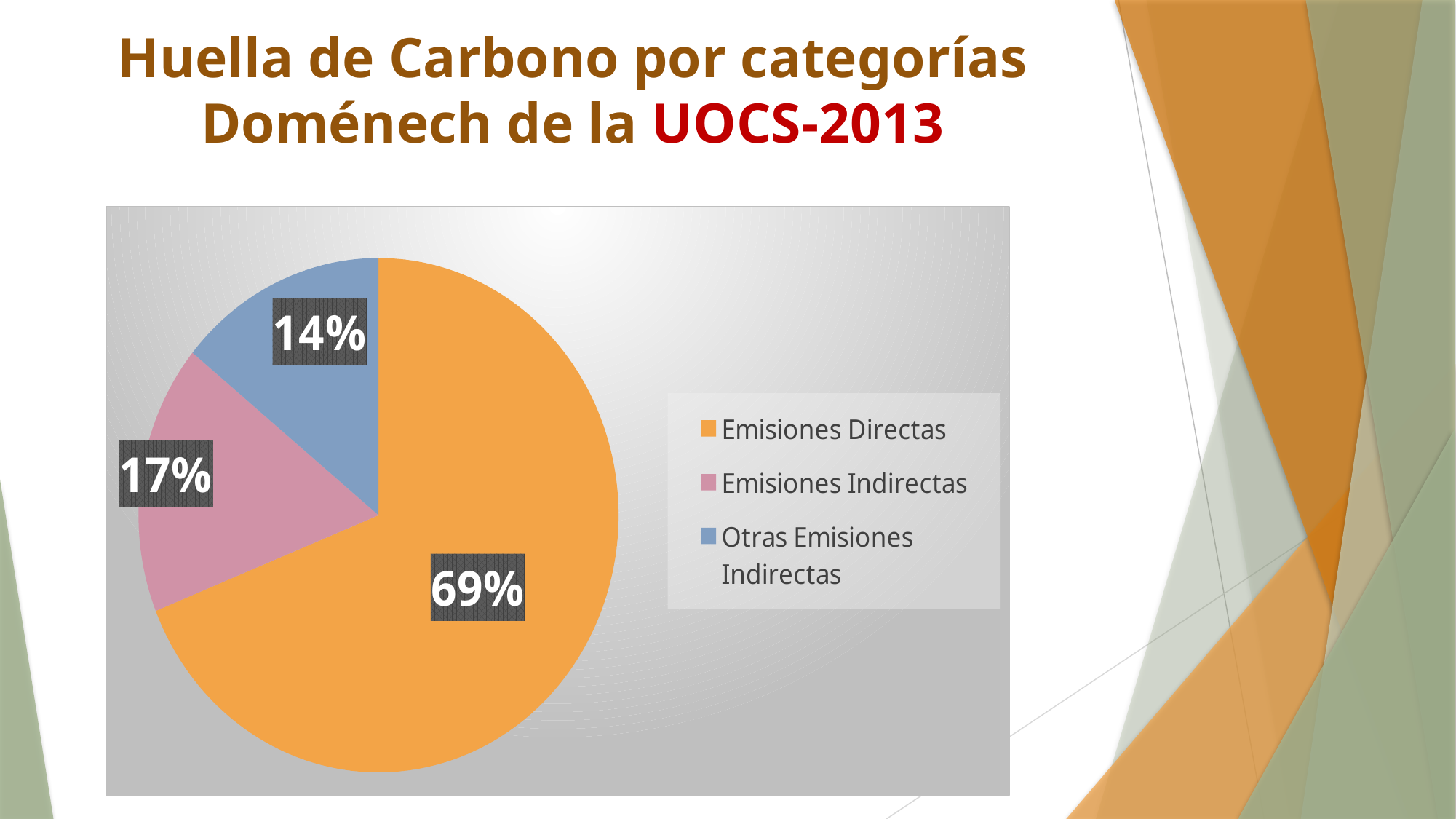
What is the difference in percentage points between Emisiones Indirectas and Otras Emisiones Indirectas? 3 What is the difference in percentage points between Emisiones Directas and Emisiones Indirectas? 52 How many slices does the pie chart have? 3 How many entries does the legend list? 3 Which category has the largest slice of the pie? Emisiones Directas Which is larger, the slice for Emisiones Indirectas or the slice for Otras Emisiones Indirectas? Emisiones Indirectas What colour is the slice for Emisiones Directas? orange What share of the pie does Otras Emisiones Indirectas represent? 14% Which category has the smallest slice of the pie? Otras Emisiones Indirectas What kind of chart is shown on the slide? pie chart What share of the pie does Emisiones Directas represent? 69% What share of the pie does Emisiones Indirectas represent? 17%